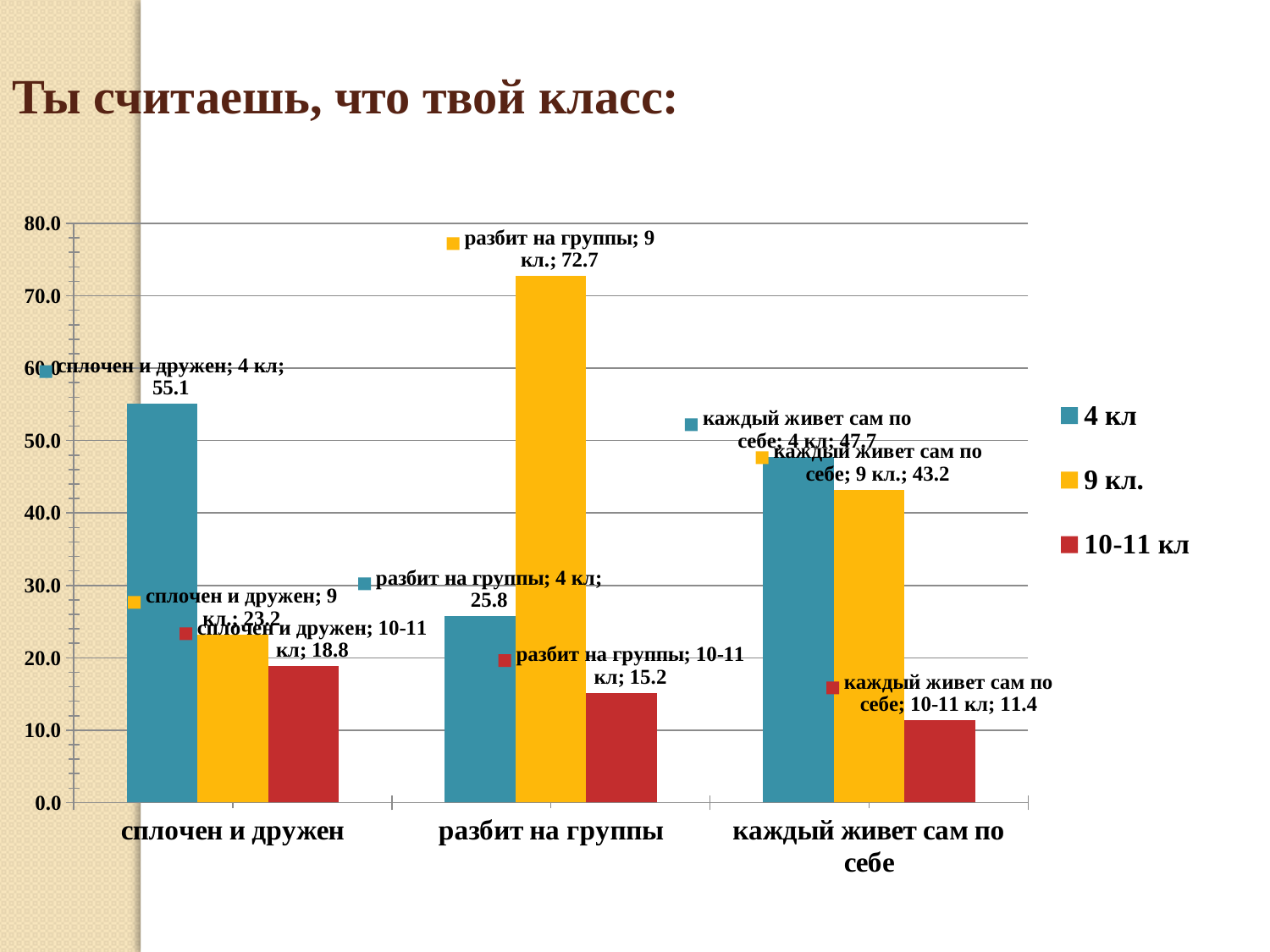
In the category "каждый живет сам по себе", which is larger: the value for 4 кл or for 9 кл.? 4 кл What is the value for 10-11 кл in the category "каждый живет сам по себе"? 11.4 What kind of chart is shown on the slide? bar chart What is the difference between the 4 кл and 10-11 кл values in the category "сплочен и дружен"? 36.3 How many series does the legend list? 3 Which category has the highest value for the 9 кл. series? разбит на группы How many categories are shown on the x axis? 3 Which category has the lowest value for the 10-11 кл series? каждый живет сам по себе Is the value for 4 кл in the category "разбит на группы" greater or less than 30.0? less What is the value for 4 кл in the category "сплочен и дружен"? 55.1 What is the value for 9 кл. in the category "разбит на группы"? 72.7 What is the title of the slide? Ты считаешь, что твой класс: